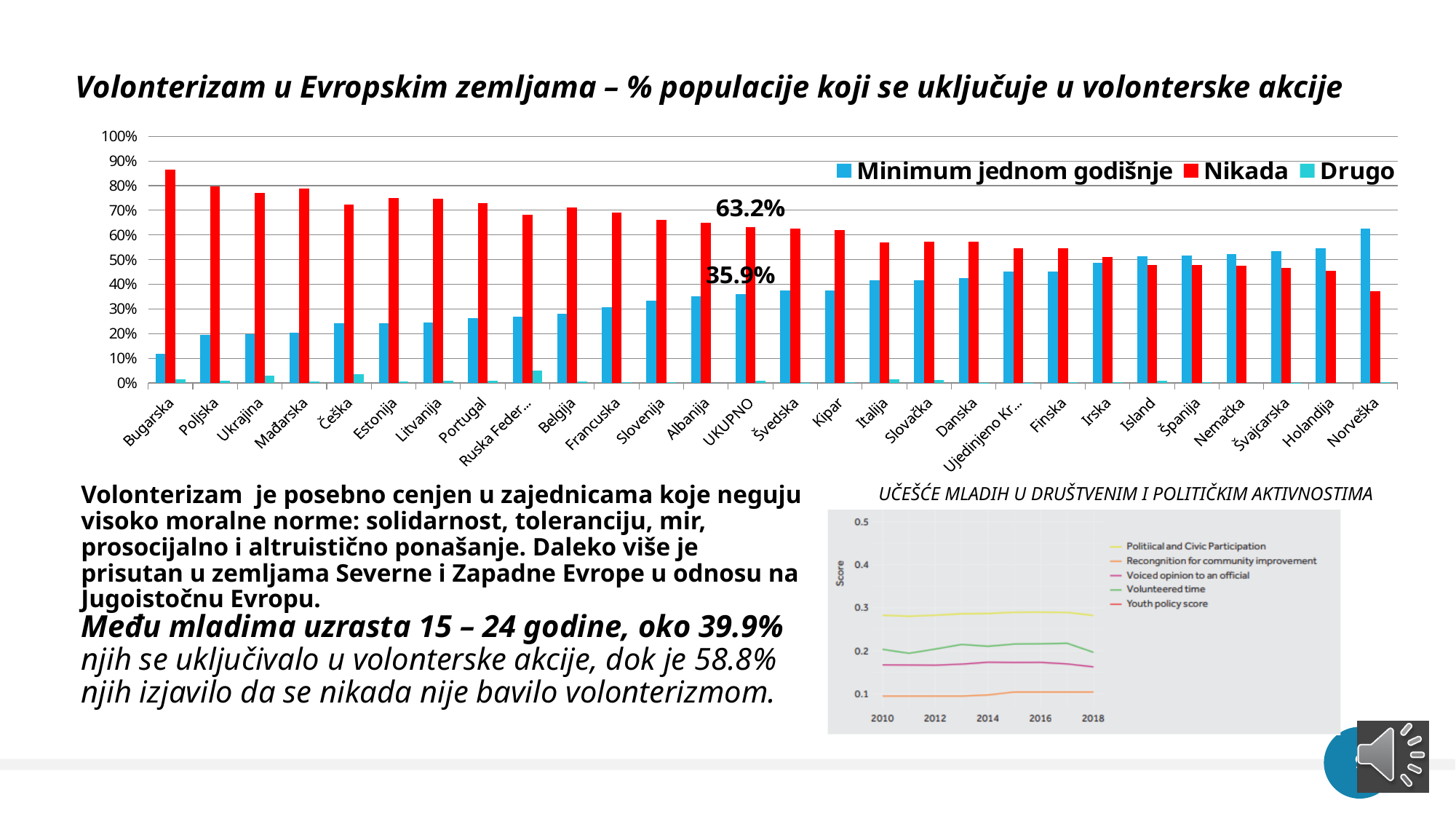
On the bar chart 'Volonterizam u Evropskim zemljama', does the 'Minimum jednom godišnje' series generally rise or fall from left to right? rise On the bar chart 'Volonterizam u Evropskim zemljama', is the 'Minimum jednom godišnje' value for Bugarska greater or less than 20%? less On the bar chart 'Volonterizam u Evropskim zemljama', is the 'Nikada' value for Bugarska greater or less than 80%? greater On the bar chart 'Volonterizam u Evropskim zemljama', how many series does the legend list? 3 On the bar chart 'Volonterizam u Evropskim zemljama', which country has the lowest 'Minimum jednom godišnje' value? Bugarska On the bar chart 'Volonterizam u Evropskim zemljama', which country has the highest 'Minimum jednom godišnje' value? Norveška On the bar chart 'Volonterizam u Evropskim zemljama', what is the 'Minimum jednom godišnje' value for UKUPNO? 35.9% On the chart 'UČEŠĆE MLADIH U DRUŠTVENIM I POLITIČKIM AKTIVNOSTIMA', how many series does the legend list? 5 On the bar chart 'Volonterizam u Evropskim zemljama', what is the 'Nikada' value for UKUPNO? 63.2% On the bar chart 'Volonterizam u Evropskim zemljama', which country has the highest 'Nikada' value? Bugarska On the bar chart 'Volonterizam u Evropskim zemljama', what is the difference between the 'Nikada' and 'Minimum jednom godišnje' values for UKUPNO? 27.3% What kind of chart is 'UČEŠĆE MLADIH U DRUŠTVENIM I POLITIČKIM AKTIVNOSTIMA'? line chart